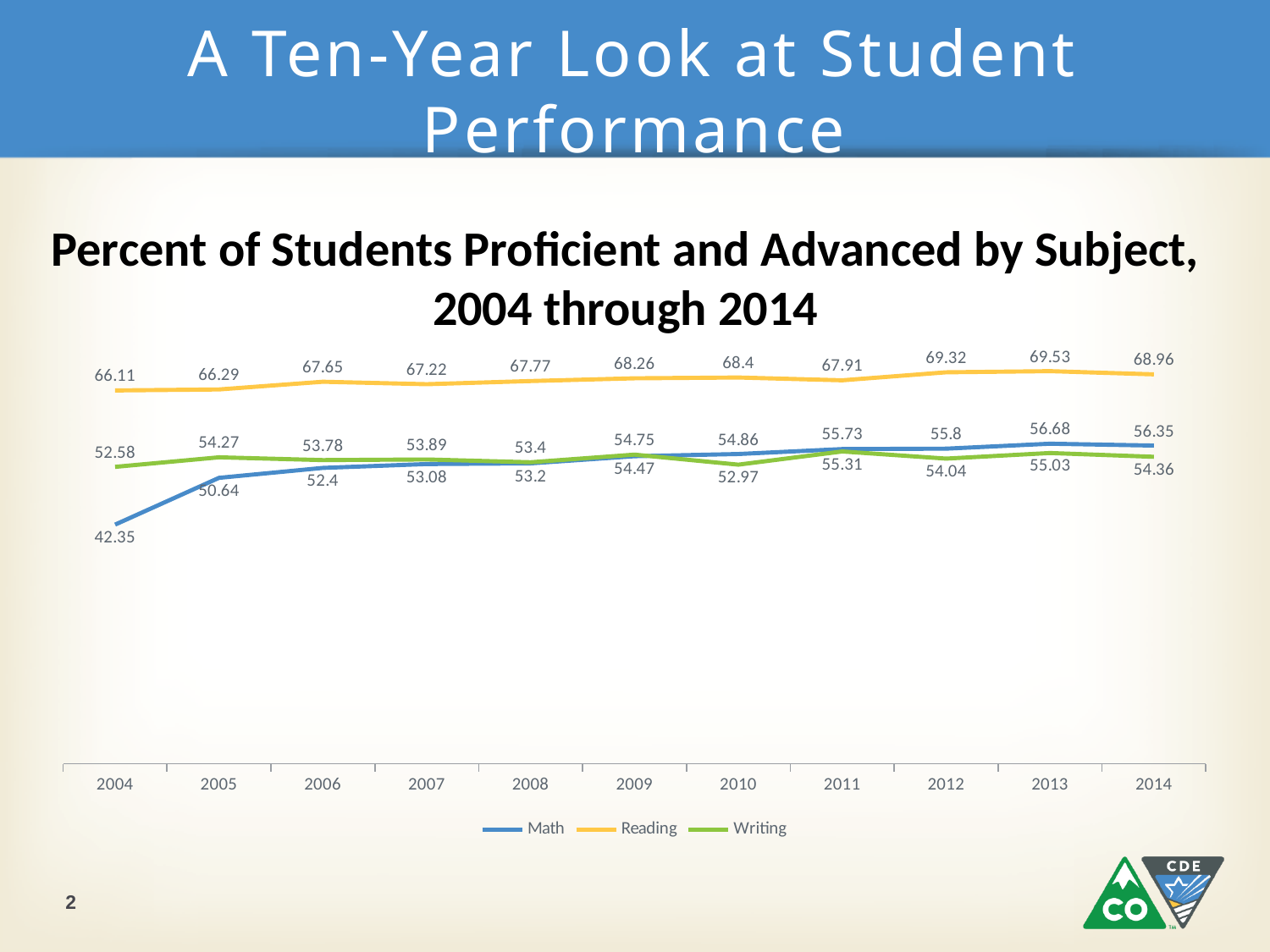
What is the Math value for 2004? 42.35 What is the Writing value for 2011? 55.31 How many years are plotted along the x axis? 11 In which year is the Math value lowest? 2004 How many series does the legend list? 3 What kind of chart is shown on the slide? Line chart Does the Reading series generally rise or fall from 2004 to 2014? Rise What is the difference between the Reading values for 2014 and 2004? 2.85 Which series has the larger value in 2010, Reading or Writing? Reading What is the Reading value for 2014? 68.96 In which year is the Reading value highest? 2013 By how much did the Math value increase from 2004 to 2005? 8.29